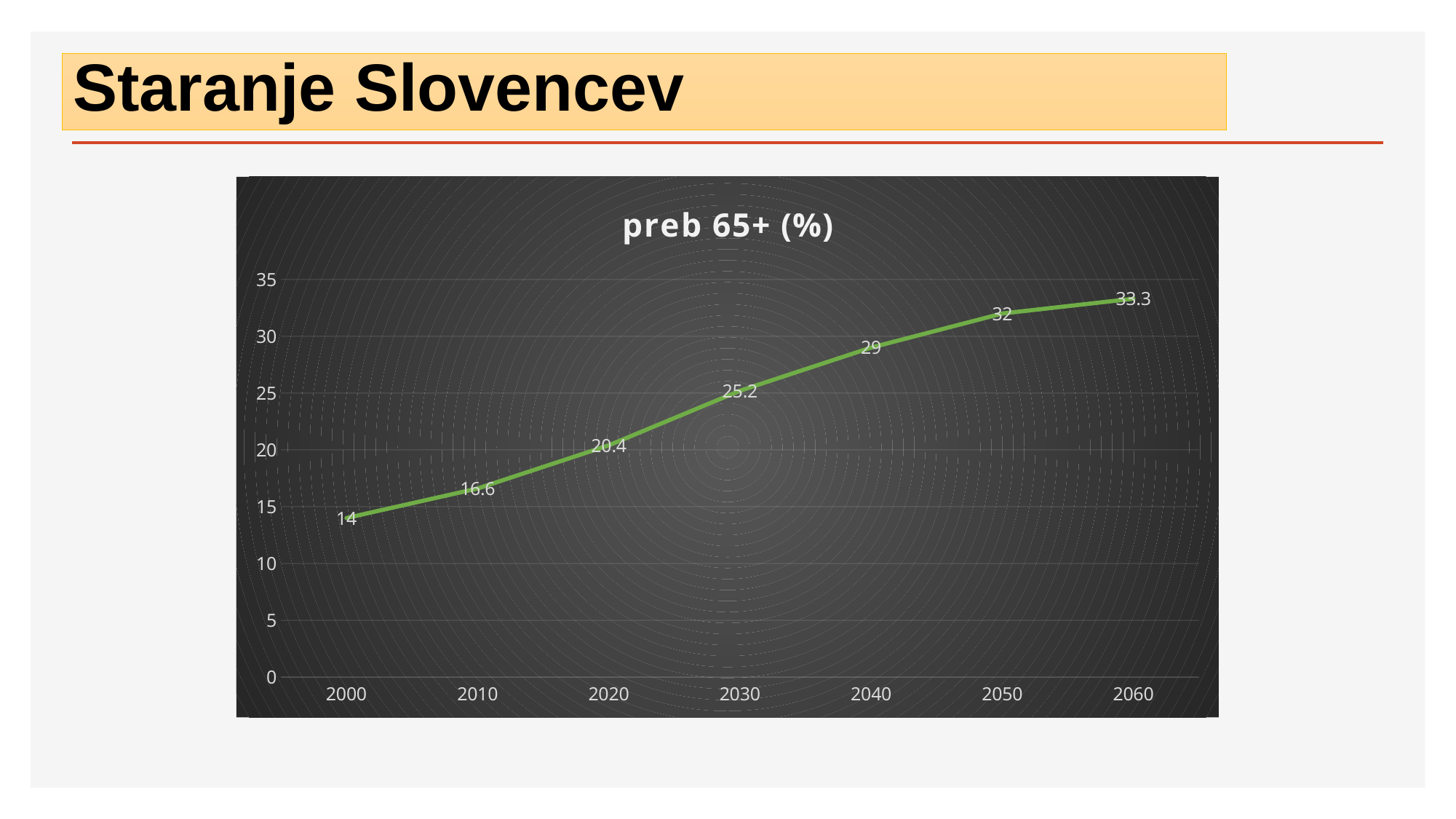
What is the difference between the values for 2040 and 2030? 3.8 What kind of chart is shown on the slide? line chart What is the value for 2060? 33.3 What is the value for 2000? 14 How many data points are plotted on the chart? 7 Which year has the lowest value? 2000 Do the values rise or fall from 2000 to 2060? rise What is the value for 2030? 25.2 What is the value for 2020? 20.4 What is the difference between the values for 2060 and 2000? 19.3 Which is larger, the value for 2010 or the value for 2050? 2050 Which year has the highest value? 2060